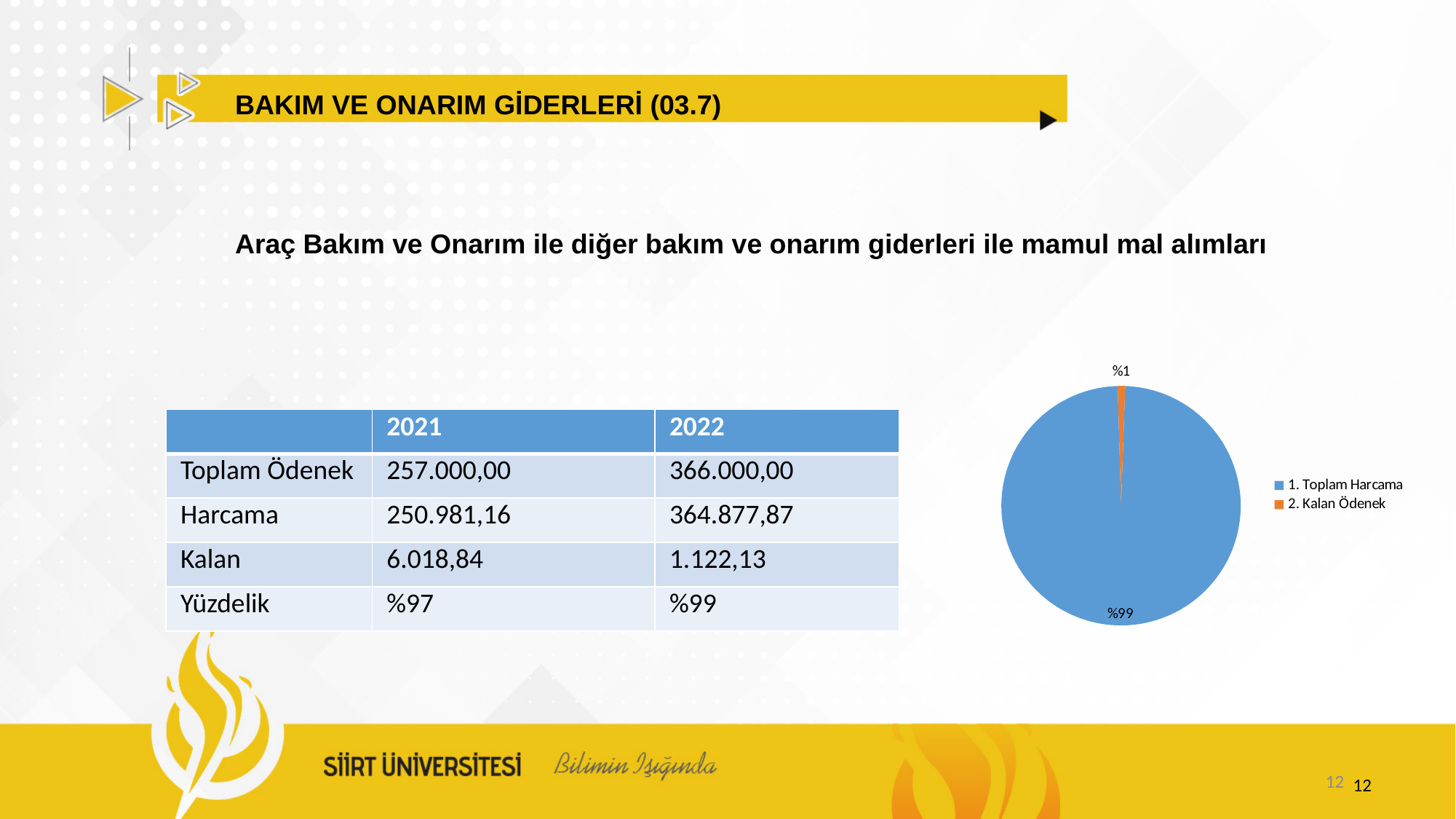
How many entries does the pie chart's legend list? 2 In the pie chart, which is larger: 1. Toplam Harcama or 2. Kalan Ödenek? 1. Toplam Harcama Which slice of the pie chart is the largest? 1. Toplam Harcama Which slice of the pie chart is the smallest? 2. Kalan Ödenek What colour is the 1. Toplam Harcama slice in the pie chart? blue What kind of chart is shown on the slide? pie chart What share of the pie chart does 1. Toplam Harcama represent? %99 How many slices does the pie chart have? 2 What colour is the 2. Kalan Ödenek slice in the pie chart? orange What is the difference in percentage points between the 1. Toplam Harcama slice and the 2. Kalan Ödenek slice in the pie chart? 98 What share of the pie chart does 2. Kalan Ödenek represent? %1